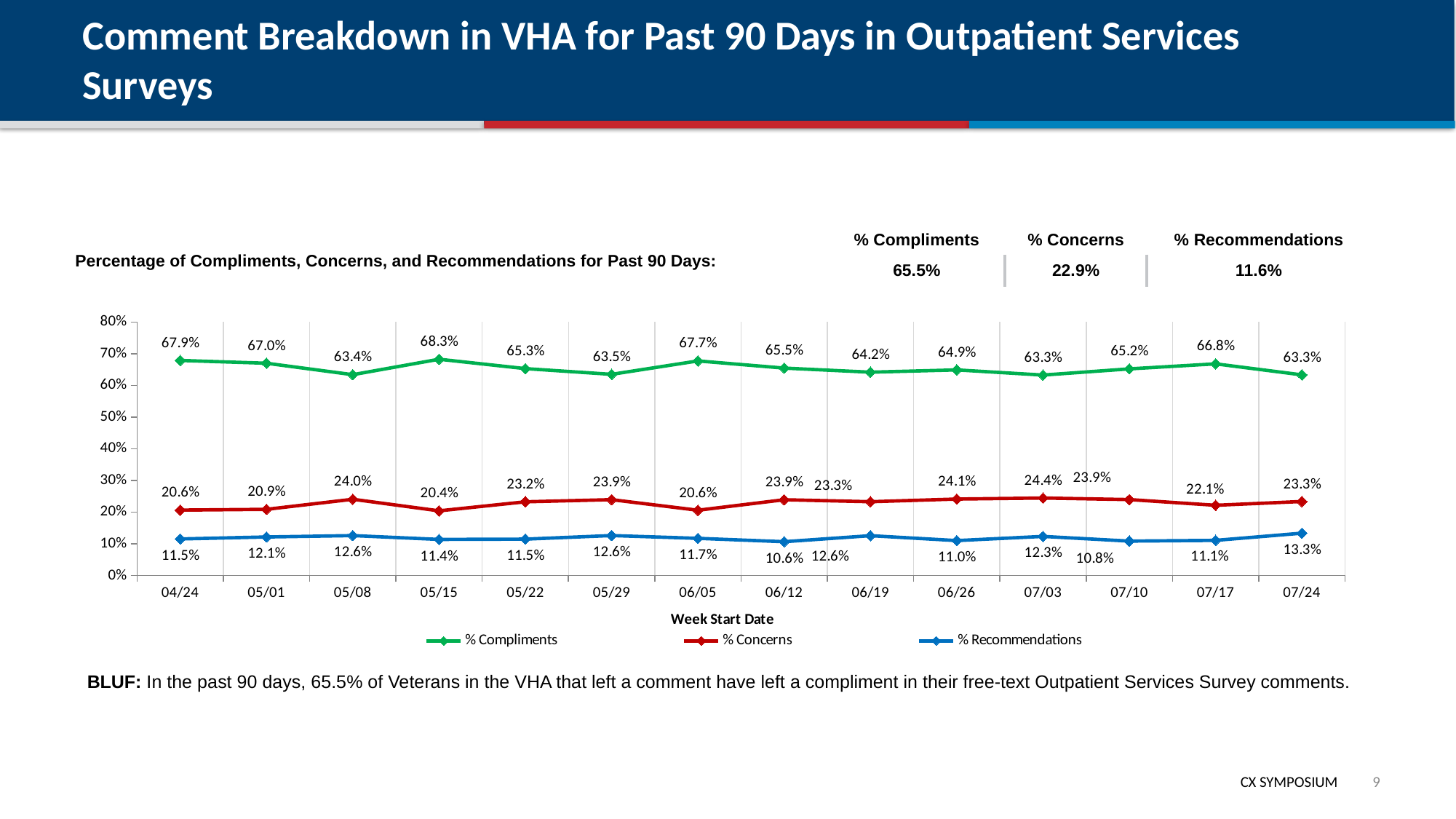
What is the % Concerns value for the week starting 07/03? 24.4% What is the % Recommendations value for the week starting 06/12? 10.6% What is the % Compliments value for the week starting 05/15? 68.3% Which is larger, the % Concerns value for 05/08 or for 05/15? 05/08 What type of chart is shown on the slide? Line chart What is the overall % Concerns figure for the past 90 days shown above the chart? 22.9% How many series does the chart legend list? 3 Which week start date has the lowest % Concerns value? 05/15 Which week start date has the highest % Compliments value? 05/15 How many week start dates are plotted along the x axis? 14 Which week start date has the highest % Recommendations value? 07/24 What is the difference between the % Compliments values for 05/15 and 07/24? 5.0%